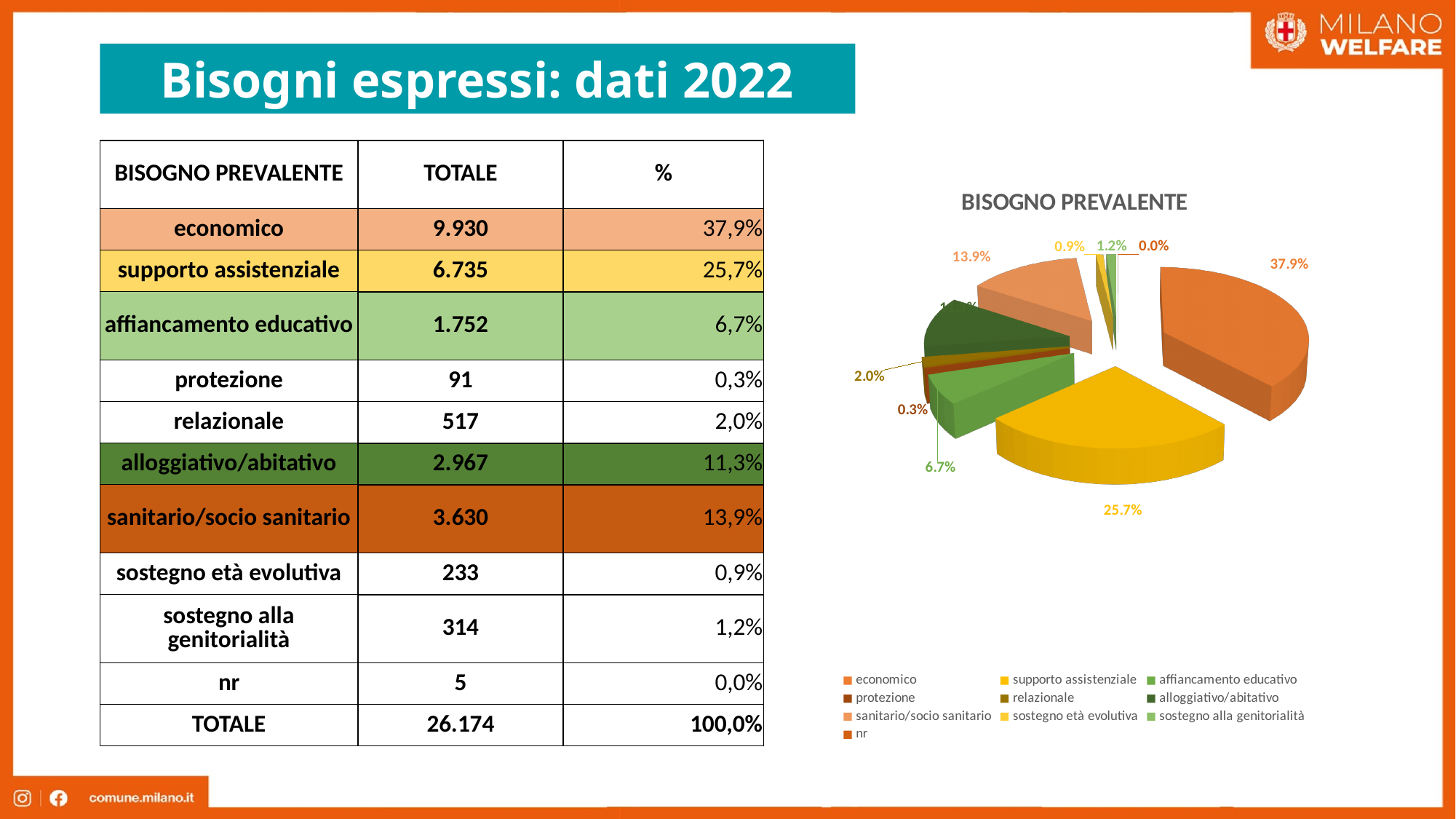
What percentage is shown for relazionale in the pie chart? 2.0% What is the difference in percentage points between the economico and supporto assistenziale slices? 12.2% How many categories does the legend of the pie chart list? 10 Which slice is larger, sanitario/socio sanitario or affiancamento educativo? sanitario/socio sanitario What percentage is shown for supporto assistenziale in the pie chart? 25.7% What type of chart is shown on the slide? pie chart What percentage is shown for affiancamento educativo in the pie chart? 6.7% Which category has the largest slice of the pie? economico What is the title of the chart? BISOGNO PREVALENTE What share of the pie does the economico slice represent? 37.9% What percentage is shown for sanitario/socio sanitario in the pie chart? 13.9% Which category has the smallest slice of the pie? nr